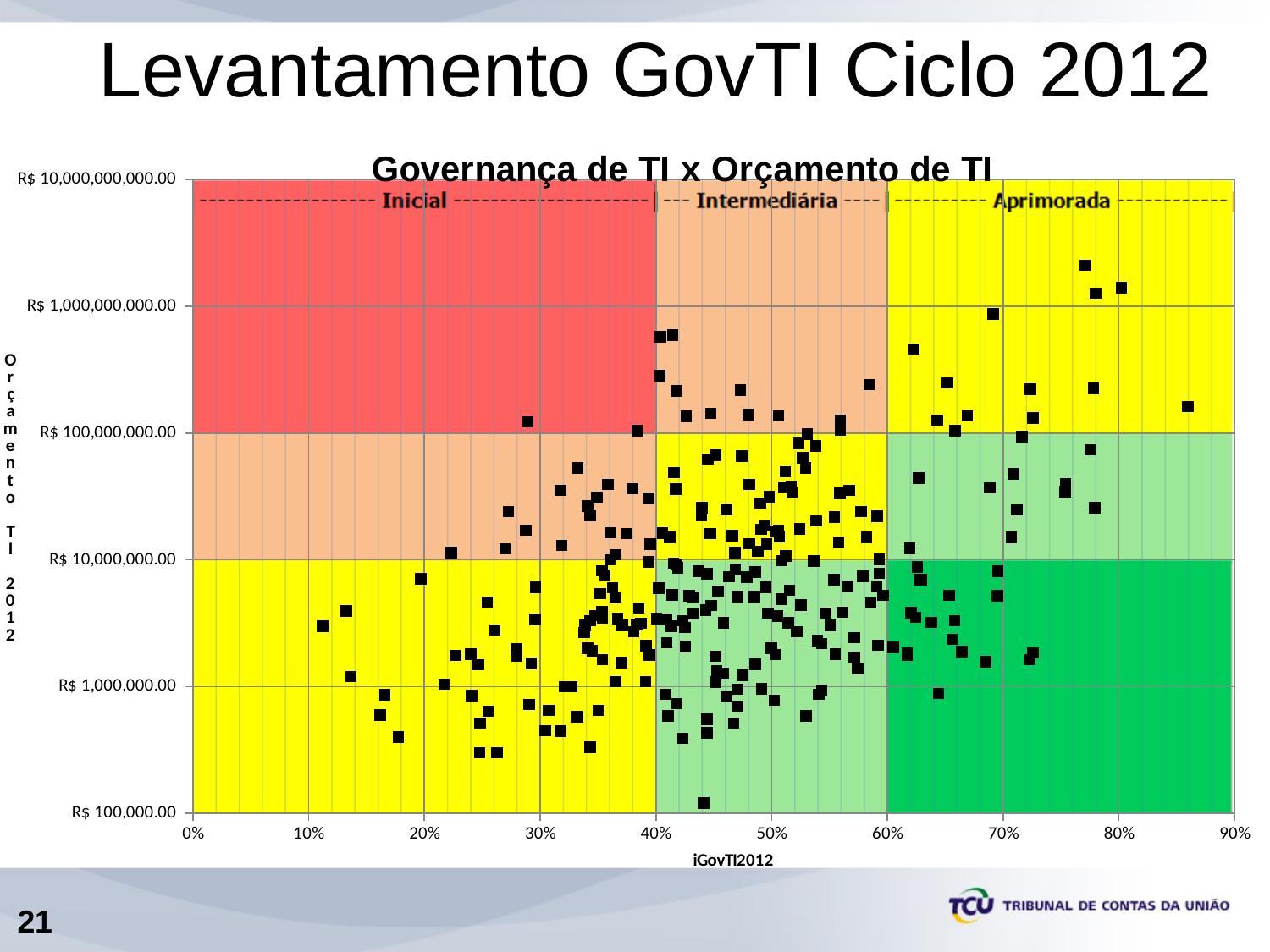
What is the title of the chart? Governança de TI x Orçamento de TI Is the budget of the highest point on the chart greater or less than R$ 1,000,000,000.00? greater Is the iGovTI2012 value of the rightmost point on the chart greater or less than 80%? greater Is the budget of the rightmost point on the chart greater or less than R$ 1,000,000,000.00? less What is the label of the x axis of the chart? iGovTI2012 What kind of chart is shown on the slide? scatter chart